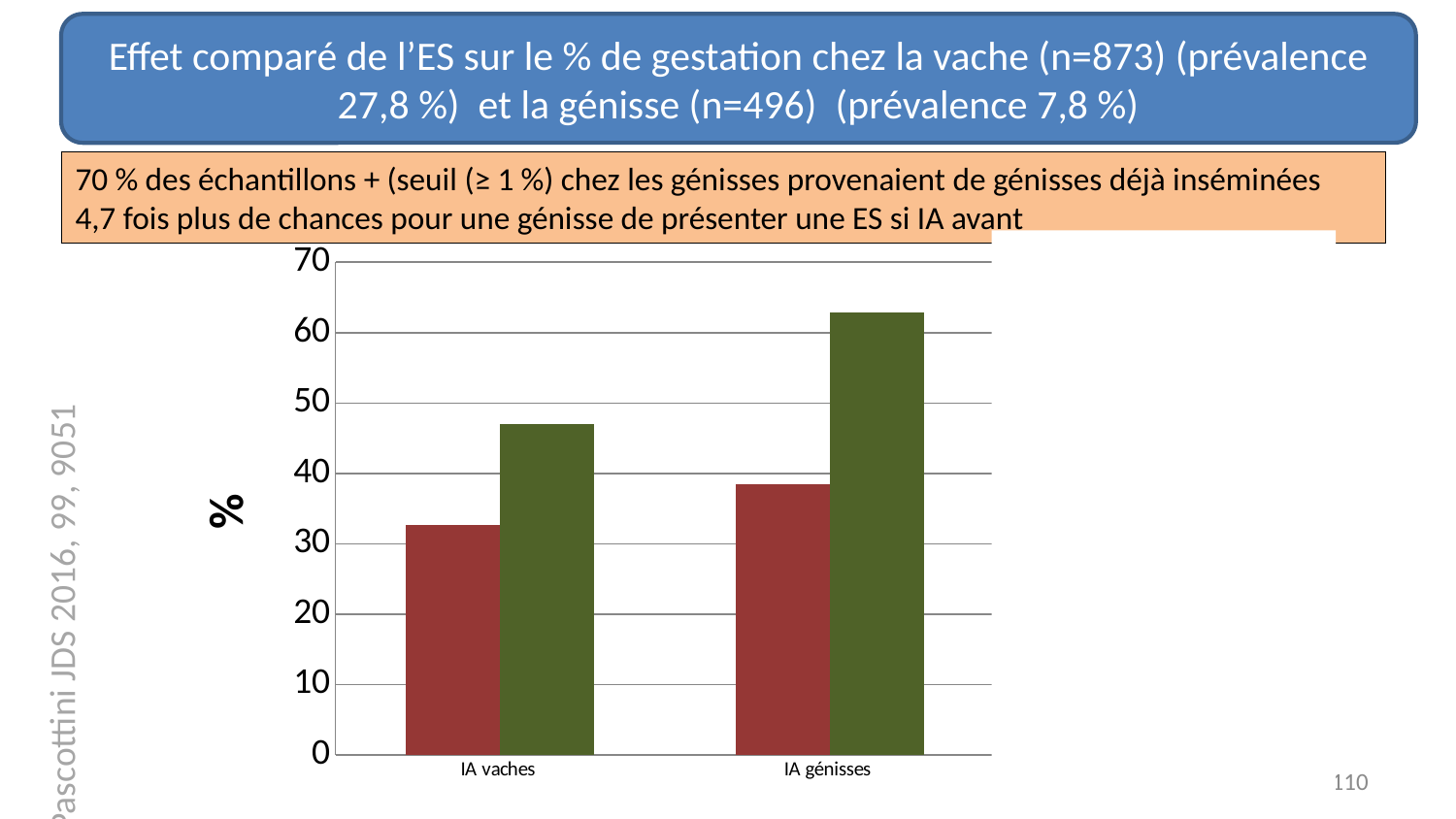
Is the value of the green bar for IA vaches greater or less than 40? greater Is the value of the red bar for IA vaches greater or less than 40? less Is the value of the red bar for IA génisses greater or less than 30? greater What are the two category labels on the x axis of the chart? IA vaches, IA génisses Which bar in the chart has the highest value? the green bar for IA génisses For IA vaches, which bar is taller, the red bar or the green bar? the green bar What kind of chart is shown on the slide? bar chart Which bar in the chart has the lowest value? the red bar for IA vaches How many categories are shown on the x axis of the chart? 2 What is the label of the vertical axis of the chart? %